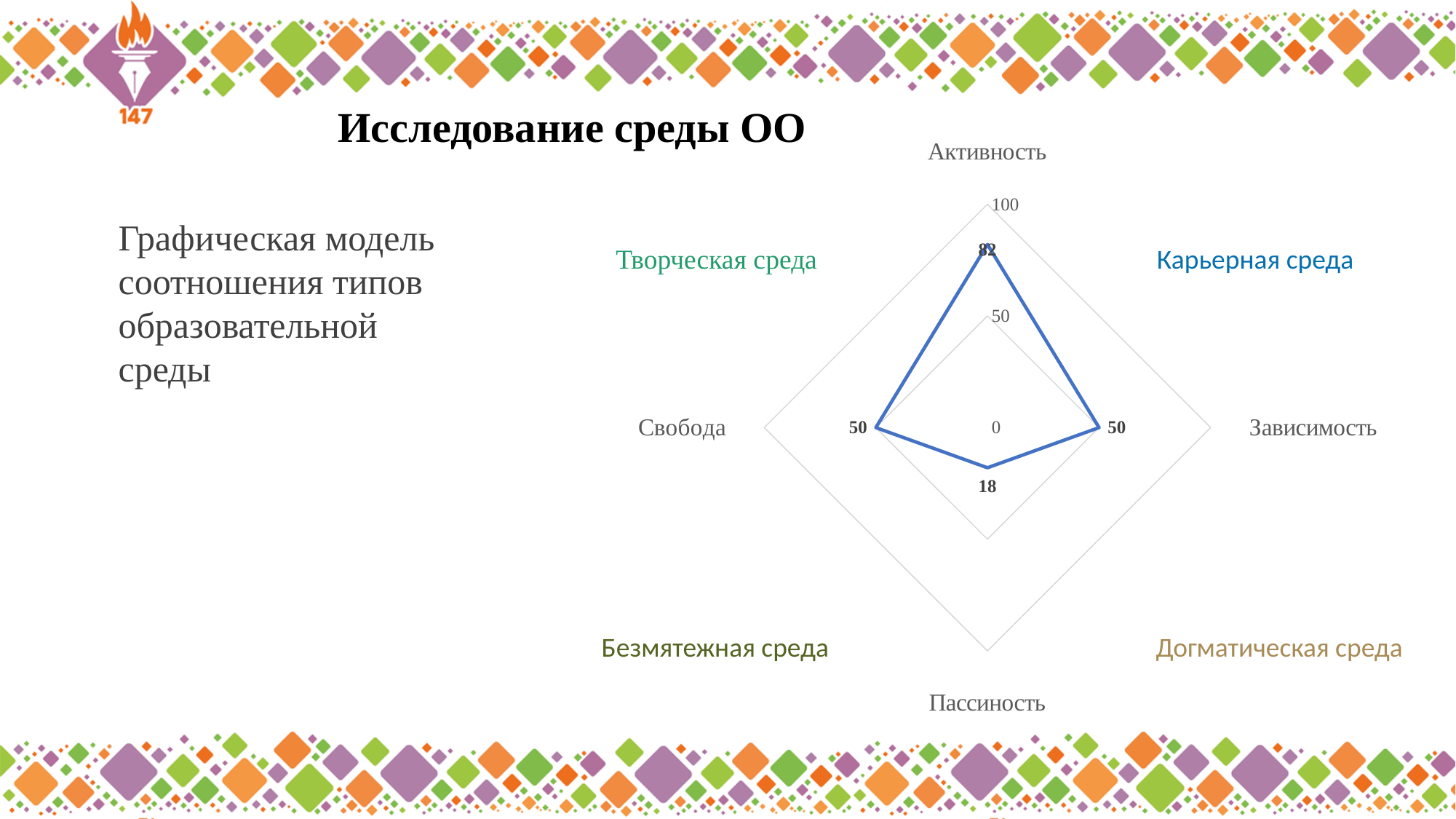
Which axis has the highest plotted value? Активность What is the value plotted for Пассиность? 18 What is the value plotted for Зависимость? 50 Which is larger, the value for Активность or the value for Зависимость? Активность What is the value plotted for Свобода? 50 What is the maximum value shown on the radar chart's scale? 100 Is the value for Пассиность greater or less than 50? less Which axis has the lowest plotted value? Пассиность What is the value plotted for Активность? 82 How many axes (categories) does the radar chart have? 4 What is the difference between the values for Активность and Пассиность? 64 What type of chart is shown on the slide? radar chart